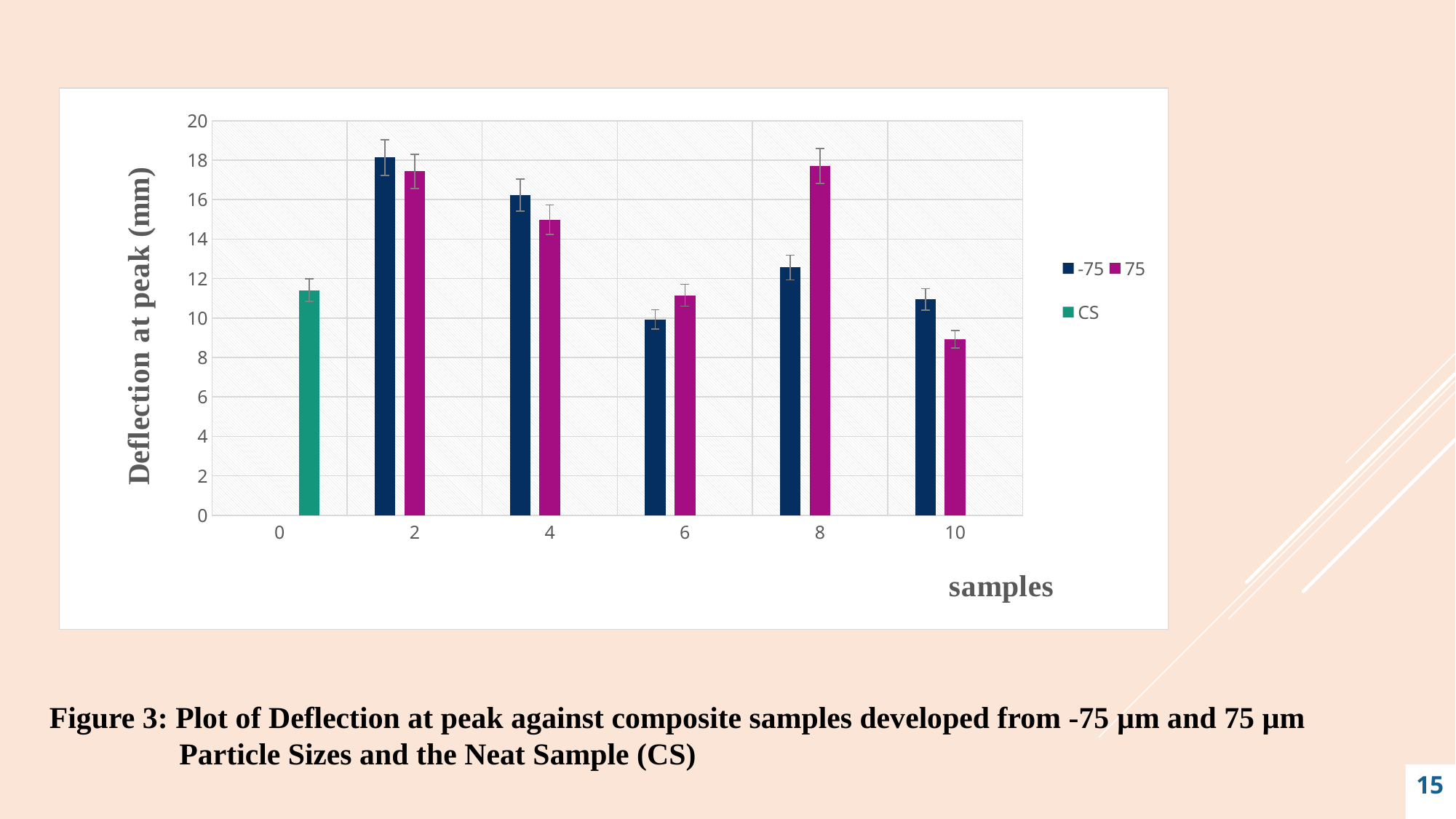
What is the title of the y axis? Deflection at peak (mm) What kind of chart is shown on the slide? bar chart Is the value for CS at sample 0 greater or less than 10? greater At sample 6, which series has the larger deflection at peak, -75 or 75? 75 Is the value for the -75 series at sample 8 greater or less than 14? less At which sample is the -75 series bar the highest? 2 Is the value for the -75 series at sample 2 greater or less than 16? greater At sample 8, which series has the larger deflection at peak, -75 or 75? 75 At which sample is the 75 series bar the lowest? 10 How many series does the legend list? 3 How many sample positions are labelled on the x axis? 6